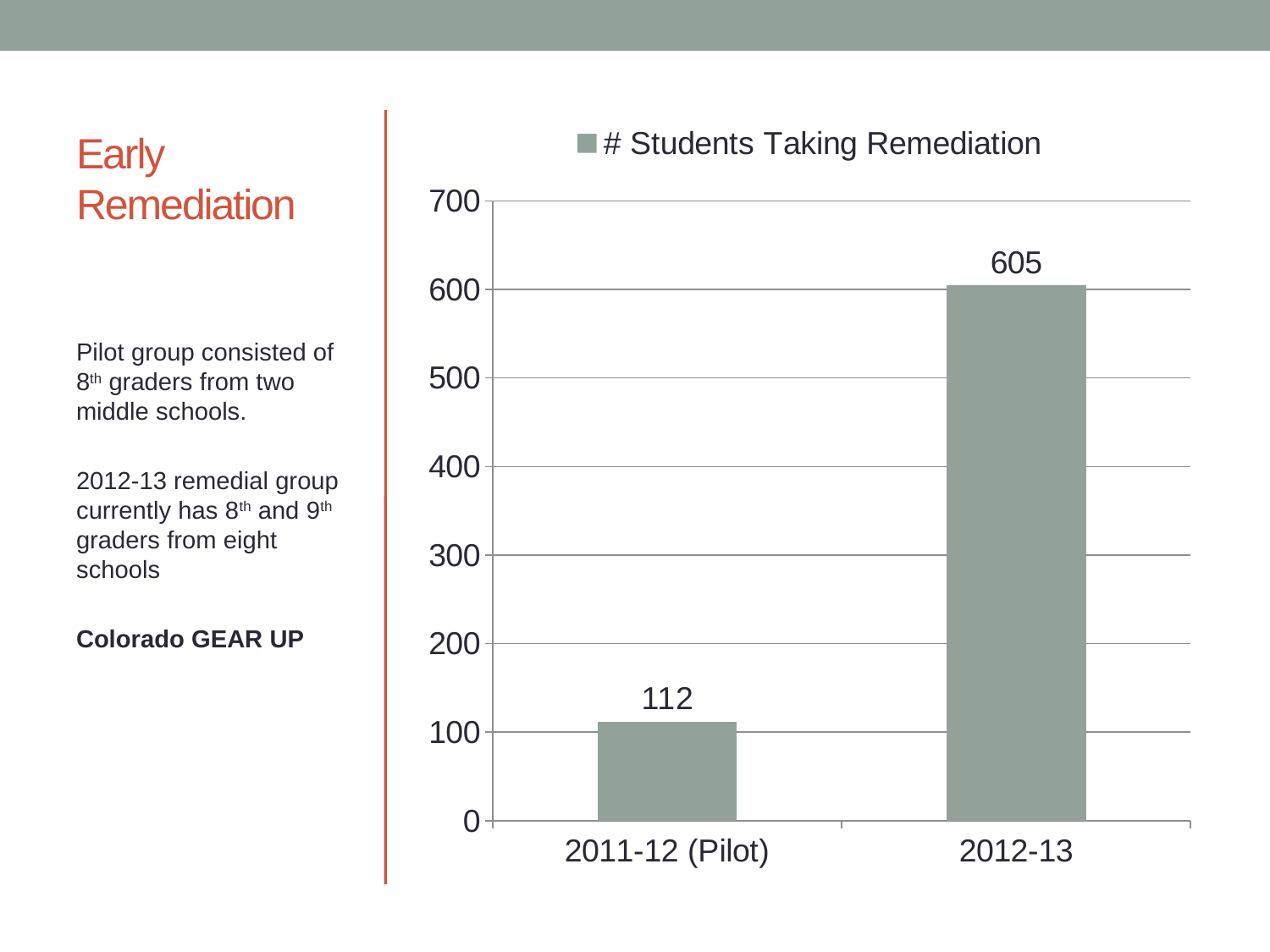
How many students took remediation in 2012-13? 605 Is the value for 2012-13 greater or less than 500? greater How many categories are shown on the x axis of the chart? 2 Is the value for 2011-12 (Pilot) greater or less than 200? less Which year has the lowest number of students taking remediation? 2011-12 (Pilot) Which is larger: the number of students taking remediation in 2011-12 (Pilot) or in 2012-13? 2012-13 How many series does the chart legend list? 1 What kind of chart is shown on the slide? bar chart Which year has the highest number of students taking remediation? 2012-13 How many students took remediation in 2011-12 (Pilot)? 112 What is the series name shown in the chart legend? # Students Taking Remediation What is the difference in the number of students taking remediation between 2012-13 and 2011-12 (Pilot)? 493